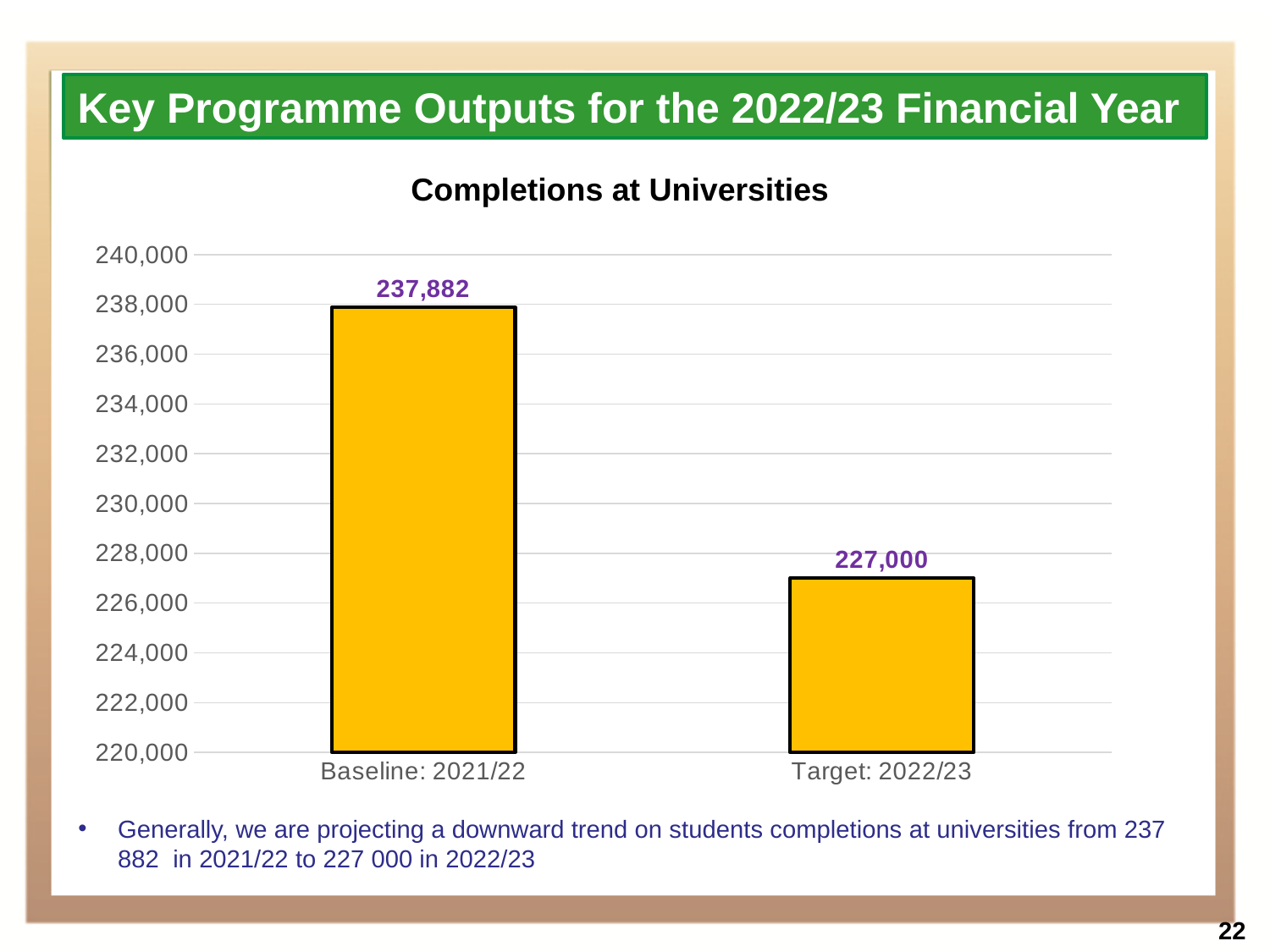
What is the difference between the Baseline: 2021/22 and Target: 2022/23 values in the Completions at Universities chart? 10,882 Which category has the highest value in the Completions at Universities chart? Baseline: 2021/22 What is the value for Target: 2022/23 in the Completions at Universities chart? 227,000 Which category has the lowest value in the Completions at Universities chart? Target: 2022/23 What kind of chart is shown on the slide? Bar chart What is the title of the chart on the slide? Completions at Universities What is the value for Baseline: 2021/22 in the Completions at Universities chart? 237,882 Which is larger in the Completions at Universities chart: Baseline: 2021/22 or Target: 2022/23? Baseline: 2021/22 Is the value for Baseline: 2021/22 greater or less than 236,000? greater Do the values rise or fall from Baseline: 2021/22 to Target: 2022/23? Fall Is the value for Target: 2022/23 greater or less than 228,000? less How many categories are shown in the Completions at Universities chart? 2